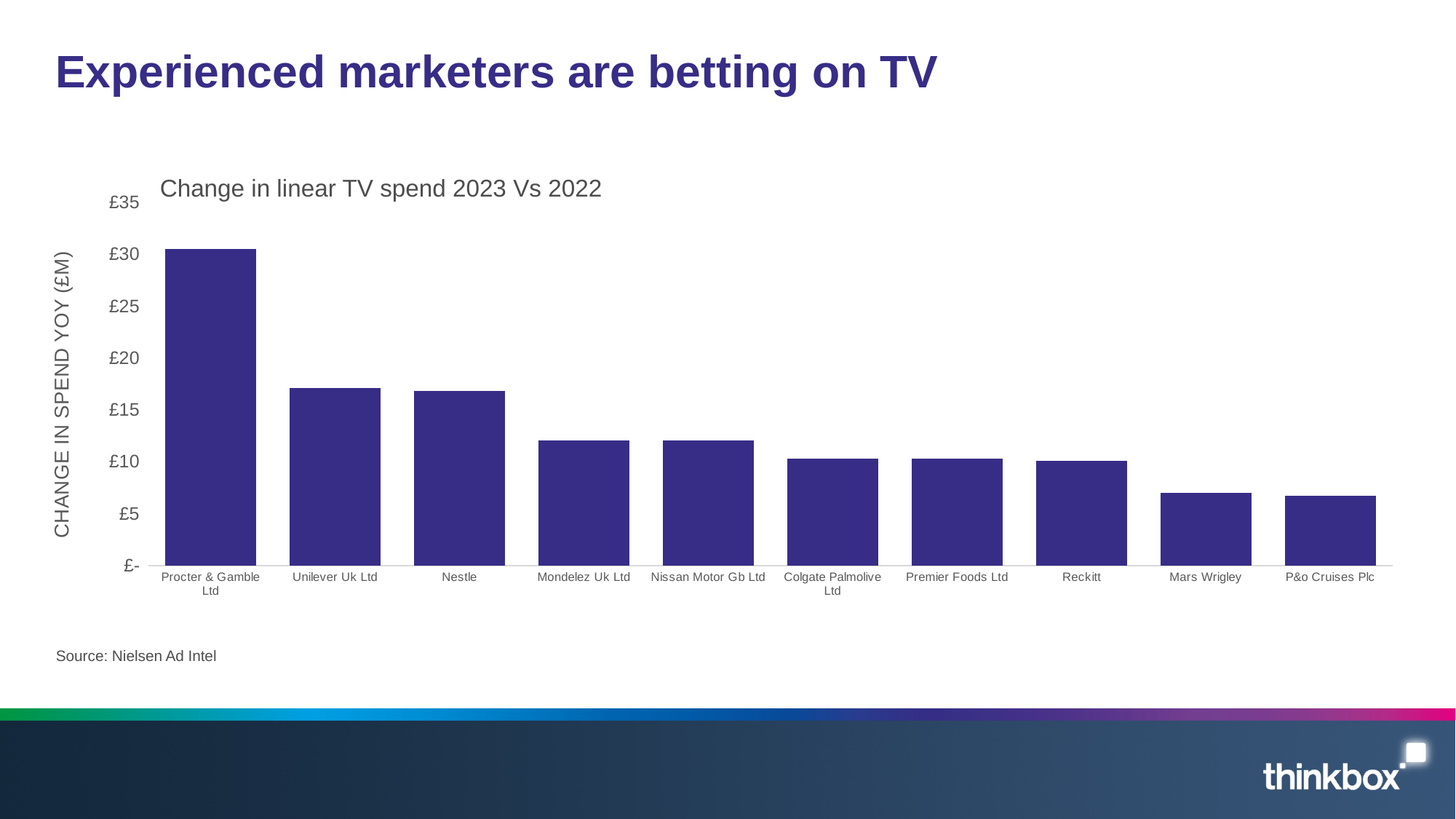
What kind of chart is shown on the slide? Bar chart Is the value for Procter & Gamble Ltd greater or less than £25? greater Is the value for Mars Wrigley greater or less than £10? less Is the value for Mondelez Uk Ltd greater or less than £10? greater Which company has the largest change in linear TV spend? Procter & Gamble Ltd Which is larger, the value for Procter & Gamble Ltd or the value for Unilever Uk Ltd? Procter & Gamble Ltd Do the values rise or fall moving from left to right along the x axis? Fall What is the title of the chart? Change in linear TV spend 2023 Vs 2022 How many companies are shown on the x axis of the chart? 10